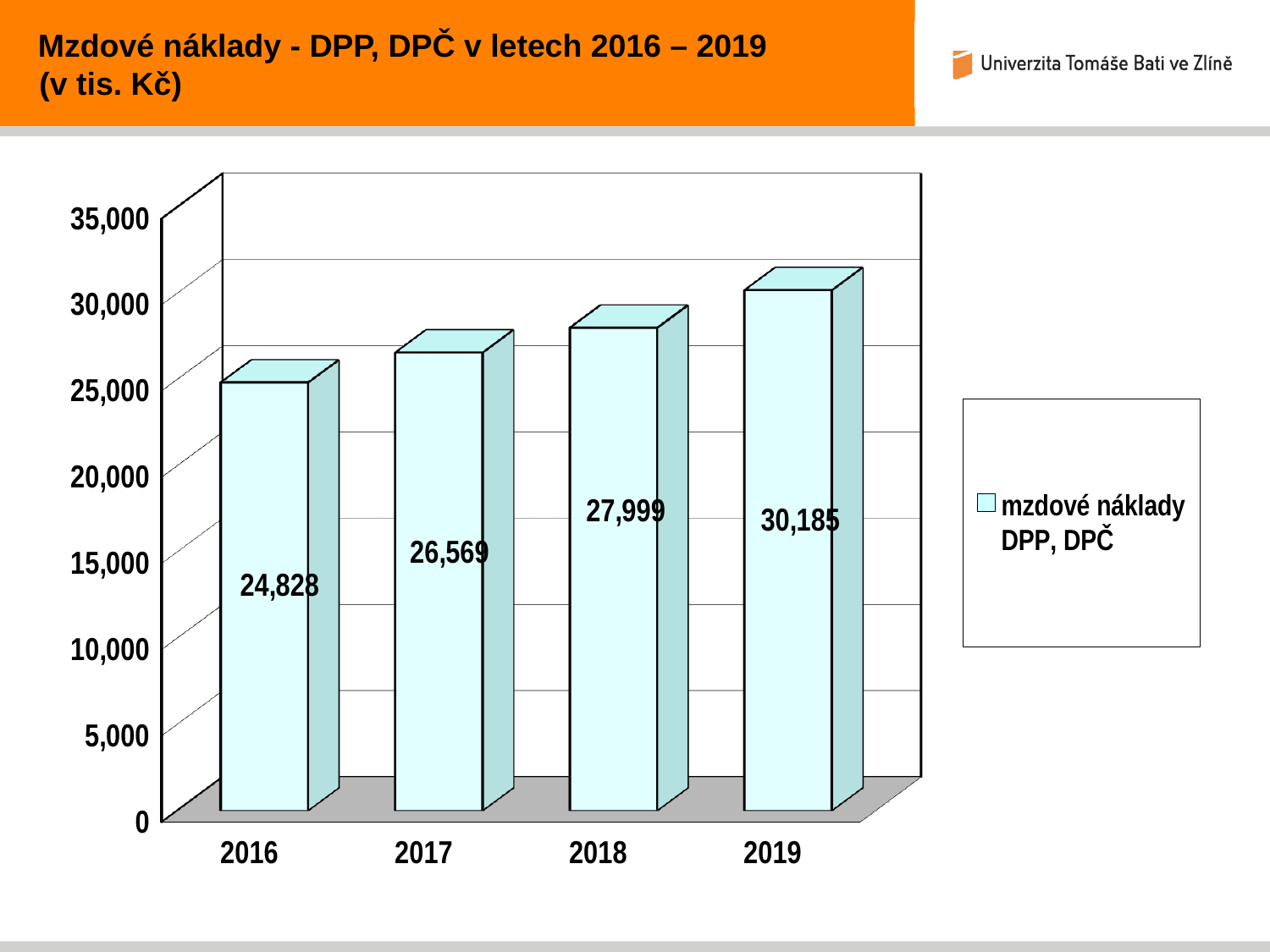
What is the value for 2018? 27,999 Which is larger, the value for 2017 or the value for 2018? 2018 What kind of chart is shown on the slide? bar chart What is the value for 2017? 26,569 What is the difference between the values for 2019 and 2016? 5,357 Do the values rise or fall from 2016 to 2019? rise Which year has the highest value? 2019 How many years are shown on the x axis? 4 Is the value for 2019 greater or less than 30,000? greater What is the value for 2019? 30,185 Which year has the lowest value? 2016 What is the value for 2016? 24,828